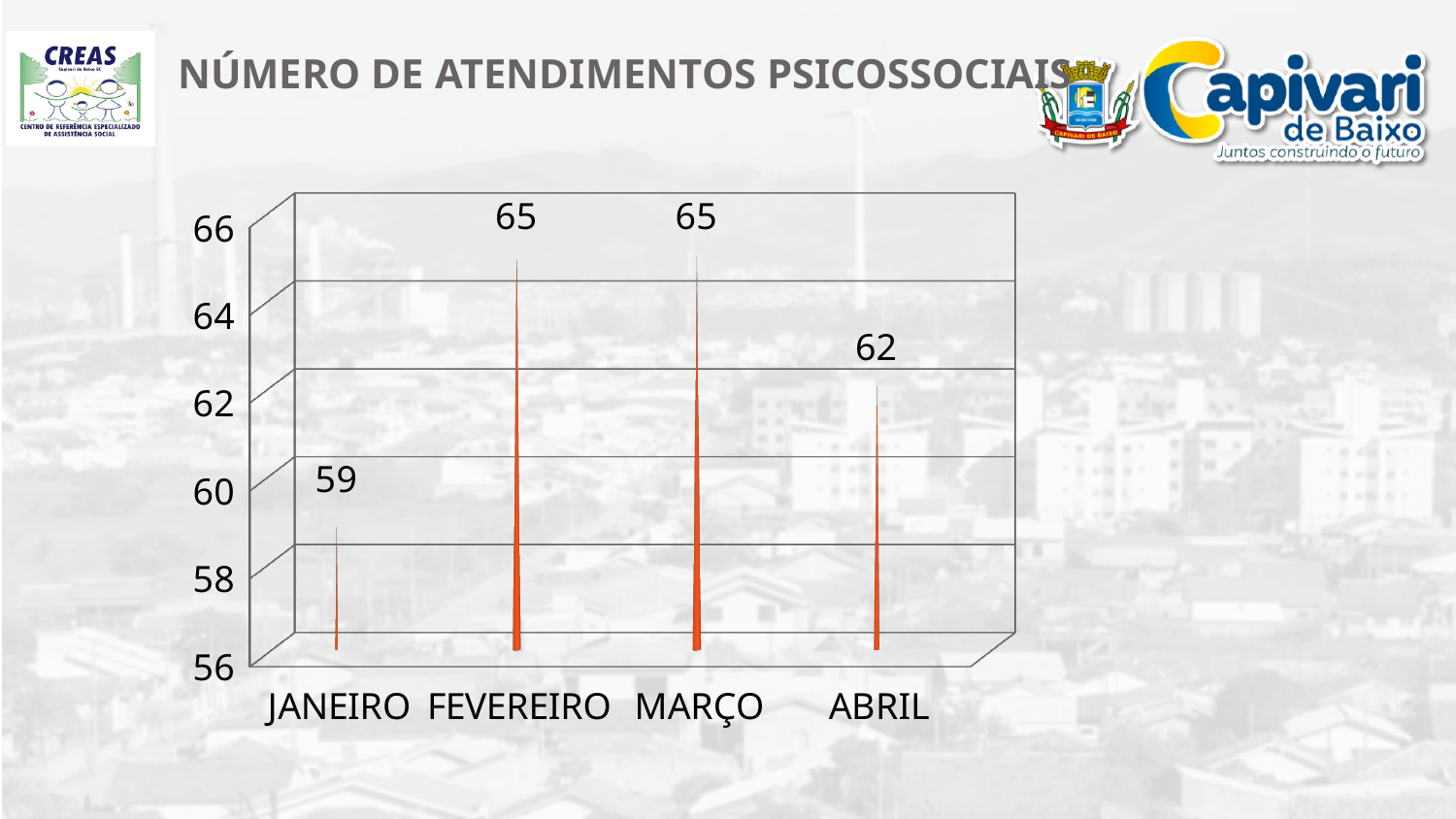
What is the value for ABRIL? 62 What is the difference between the values for FEVEREIRO and JANEIRO? 6 Which month has the lowest value? JANEIRO What is the value for JANEIRO? 59 Is the value for ABRIL greater or less than 60? greater Do the values rise or fall from JANEIRO to FEVEREIRO? rise How many months are shown on the x axis? 4 Which is larger, the value for ABRIL or the value for JANEIRO? ABRIL What is the title of the chart? NÚMERO DE ATENDIMENTOS PSICOSSOCIAIS What is the value for FEVEREIRO? 65 What is the difference between the values for MARÇO and ABRIL? 3 What kind of chart is shown? bar chart